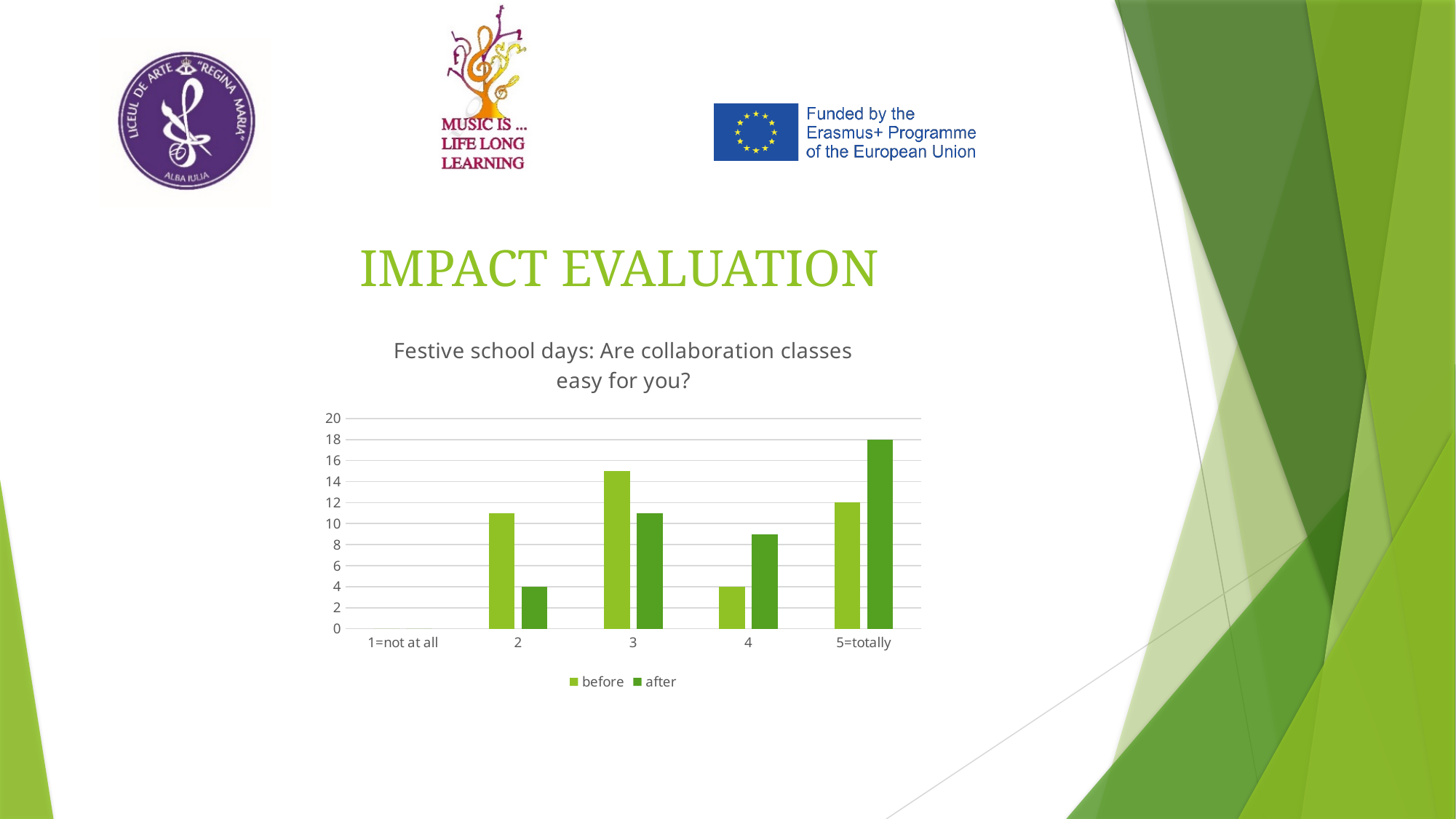
What is the value for 'after' in category 2? 4 How many series does the legend list? 2 What is the value for 'before' in category 5=totally? 12 Which category has the highest value for 'after'? 5=totally Which category has the highest value for 'before'? 3 In category 2, which is larger, 'before' or 'after'? before What is the value for 'after' in category 5=totally? 18 Is the value for 'after' in category 4 greater or less than 10? less What is the difference between 'after' and 'before' in category 5=totally? 6 How many categories are shown on the x axis? 5 What is the title of the chart? Festive school days: Are collaboration classes easy for you? What kind of chart is shown on the slide? bar chart